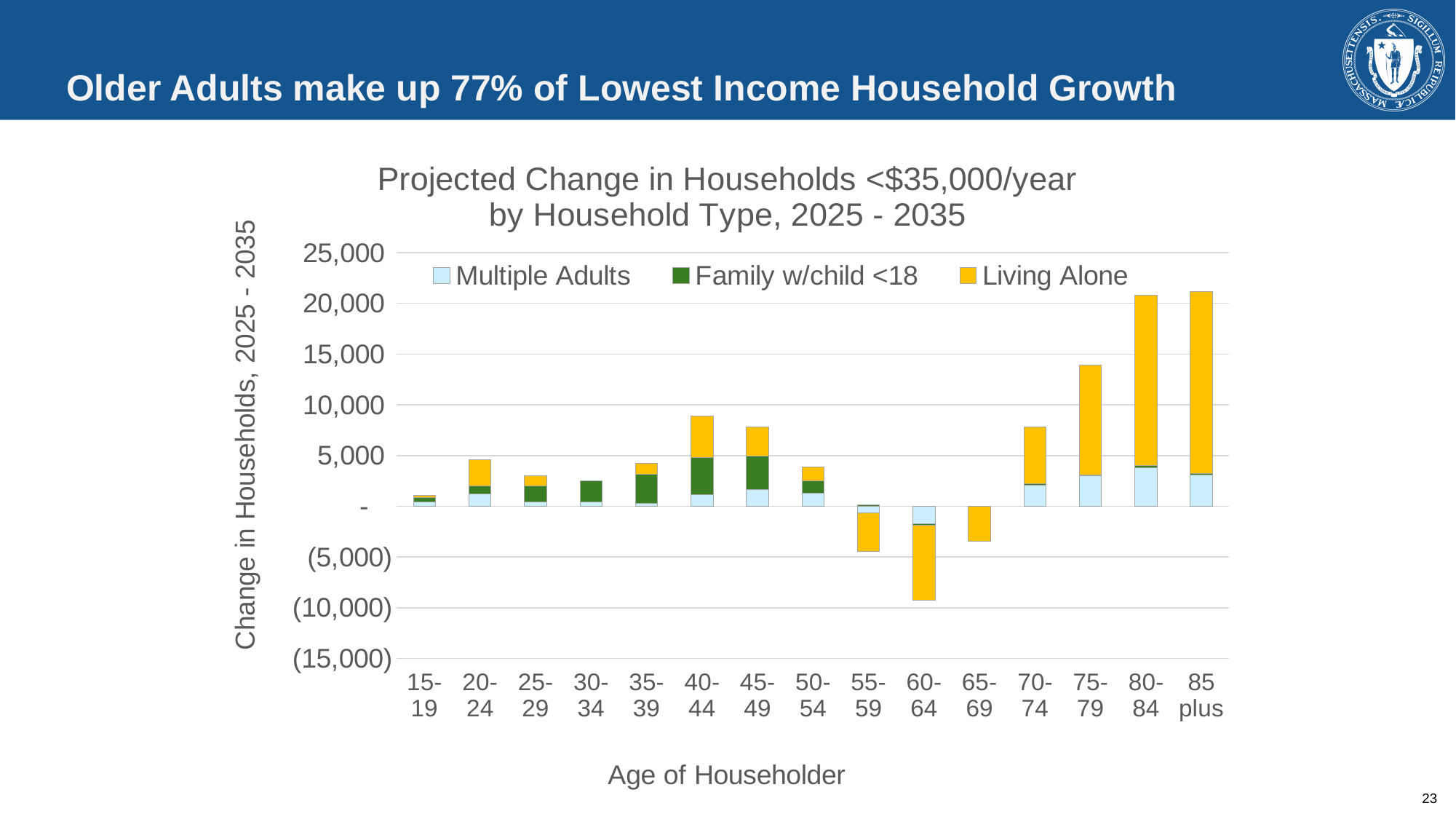
Which age group has the larger total change in households, 70-74 or 75-79? 75-79 Which age group has the lowest (most negative) total change in households? 60-64 Is the total change in households for the 75-79 age group greater or less than 10,000? greater How many age groups are shown on the x axis of the chart? 15 Is the total change in households for the 70-74 age group greater or less than 5,000? greater What is the title of the x axis of the chart? Age of Householder Is the total change in households for the 40-44 age group greater or less than 10,000? less Which age group has the larger total change in households, 20-24 or 25-29? 20-24 How many series does the chart's legend list? 3 Do the total bar heights rise or fall from the 70-74 age group to the 85 plus age group? rise What kind of chart is shown on the slide? Stacked bar chart